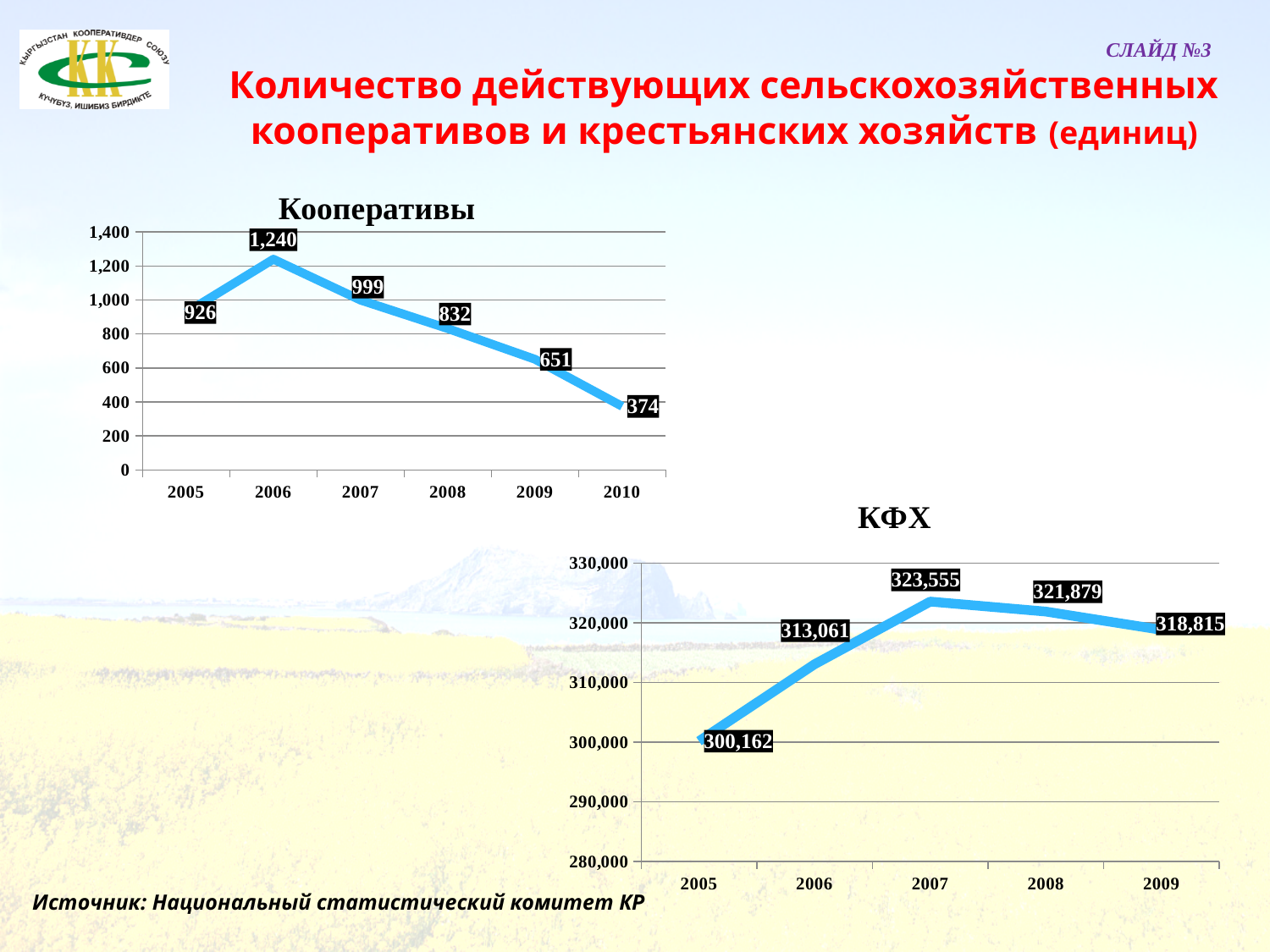
In the 'КФХ' chart, what is the value for 2005? 300,162 In the 'КФХ' chart, which is larger, the value for 2006 or the value for 2009? 2009 In the 'КФХ' chart, what is the value for 2007? 323,555 In the 'Кооперативы' chart, what is the value for 2010? 374 In the 'Кооперативы' chart, which year has the lowest value? 2010 In the 'Кооперативы' chart, what is the difference between the values for 2006 and 2010? 866 In the 'Кооперативы' chart, do the values rise or fall from 2006 to 2010? fall In the 'КФХ' chart, which year has the highest value? 2007 In the 'Кооперативы' chart, which year has the highest value? 2006 In the 'Кооперативы' chart, what is the value for 2006? 1,240 What kind of chart is the 'КФХ' chart? line chart In the 'Кооперативы' chart, how many years are plotted? 6